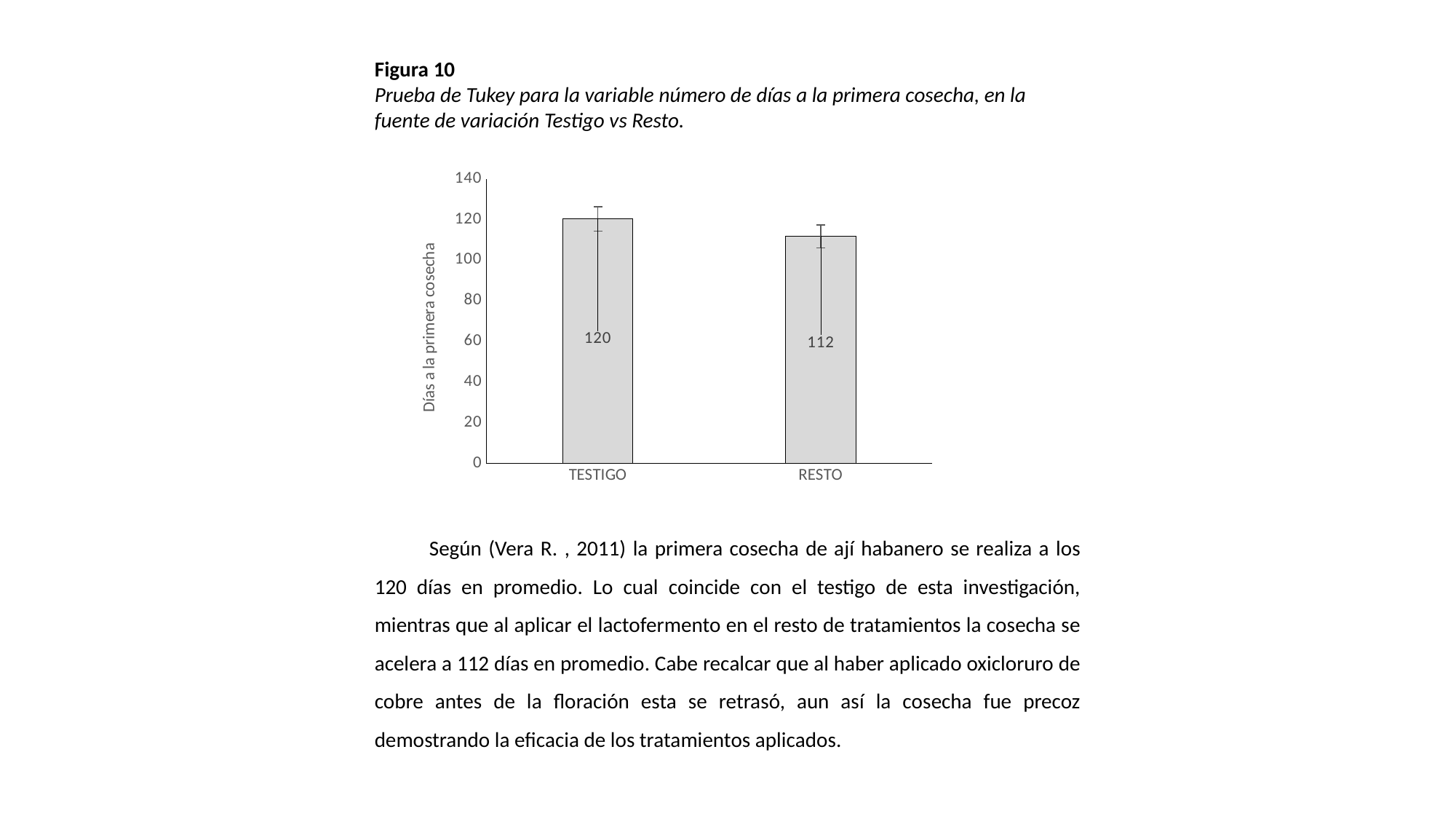
What is the label of the y axis? Días a la primera cosecha What is the value for RESTO? 112 Which is larger, the value for TESTIGO or the value for RESTO? TESTIGO Which category has the highest value? TESTIGO How many categories are shown on the x axis? 2 What is the value for TESTIGO? 120 What kind of chart is shown? bar chart Do the values rise or fall from TESTIGO to RESTO? fall Is the value for TESTIGO greater or less than 140? less Which category has the lowest value? RESTO Is the value for RESTO greater or less than 100? greater What is the difference between the values for TESTIGO and RESTO? 8